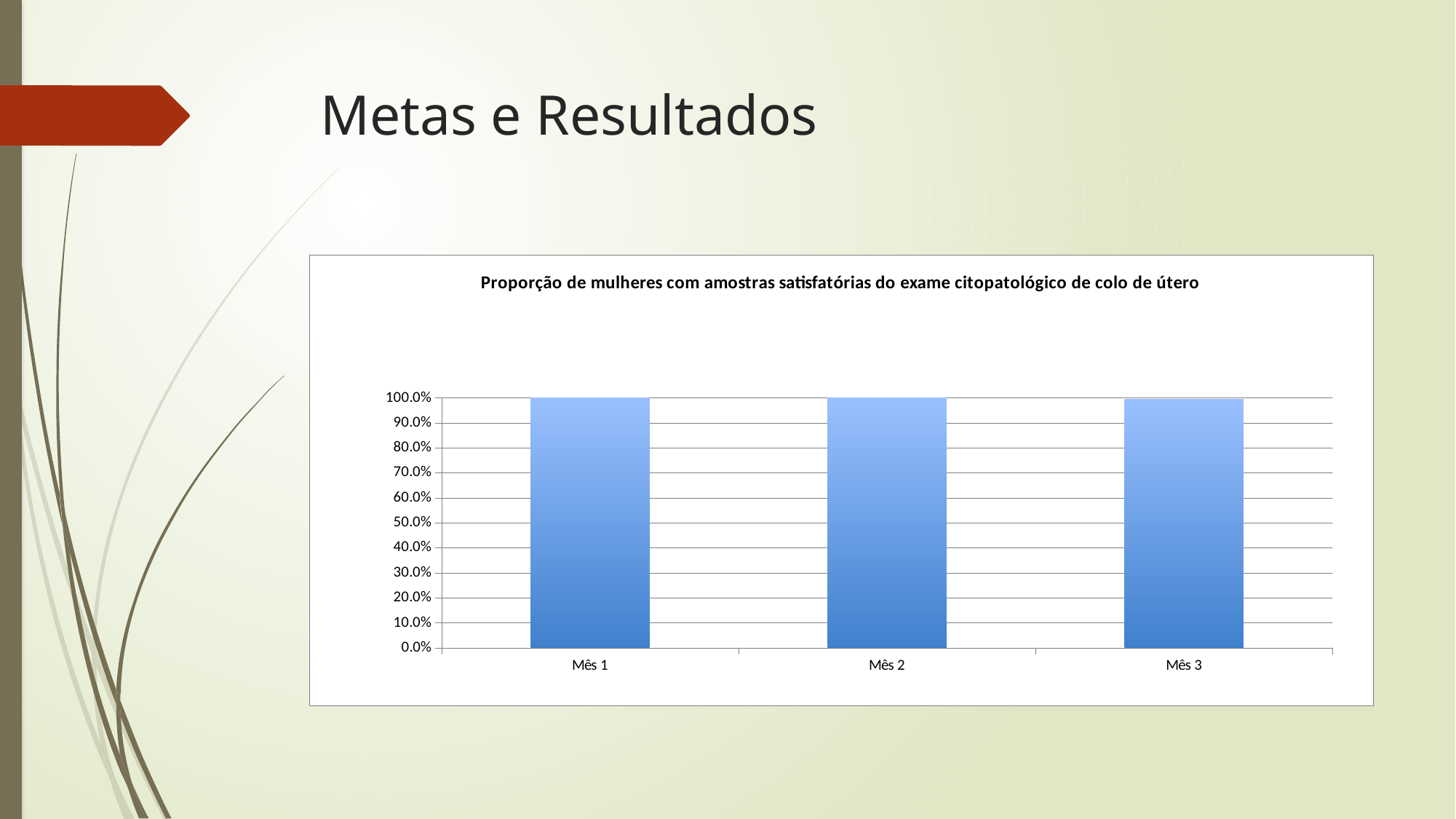
Is the value for Mês 3 greater or less than 90.0%? greater What type of chart is shown on the slide? bar chart Is the value for Mês 2 greater or less than 50.0%? greater What is the highest value shown on the y axis of the chart? 100.0% What is the value for Mês 2? 100.0% What is the value for Mês 1? 100.0% How many categories are shown on the x axis of the chart? 3 What is the title of the chart? Proporção de mulheres com amostras satisfatórias do exame citopatológico de colo de útero